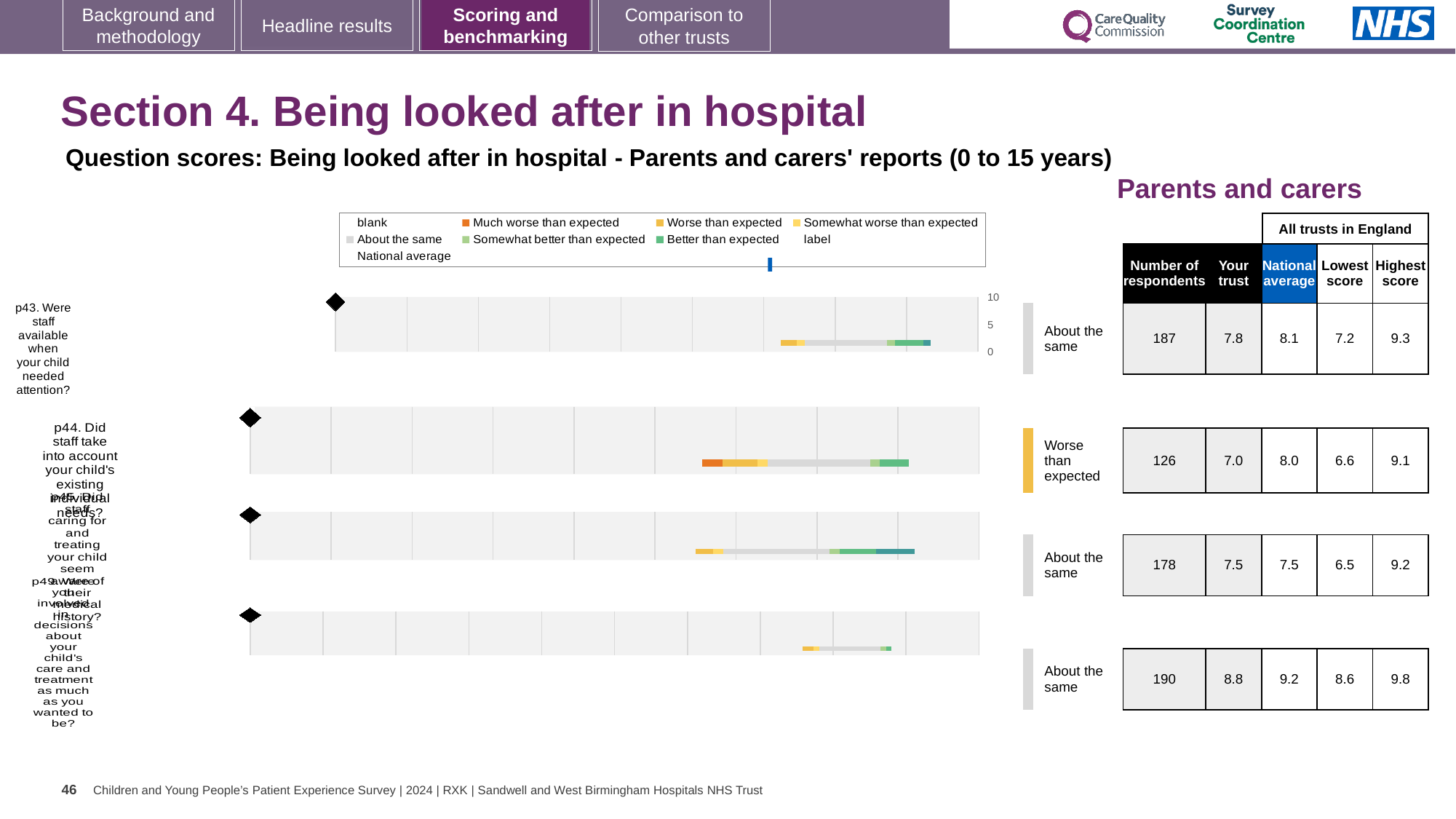
Which row has the lowest 'Your trust' score? the second row (p44), 7.0 What is the number of respondents for p43 (Were staff available when your child needed attention?)? 187 What is the 'Your trust' score for p43 (Were staff available when your child needed attention?)? 7.8 For p43, which is larger: the 'Your trust' score or the national average? national average What kind of chart is used to show the question scores on this slide? bar chart What benchmark category is shown for the second row (p44)? Worse than expected What is the 'Your trust' score for the second row (p44)? 7.0 How many questions (rows) are plotted in the chart? 4 Which row has the highest 'Your trust' score? the fourth row (p49), 8.8 For p43, what is the difference between the national average and the 'Your trust' score? 0.3 What is the highest score across all trusts in England for the fourth row (p49)? 9.8 What is the national average for p43 (Were staff available when your child needed attention?)? 8.1